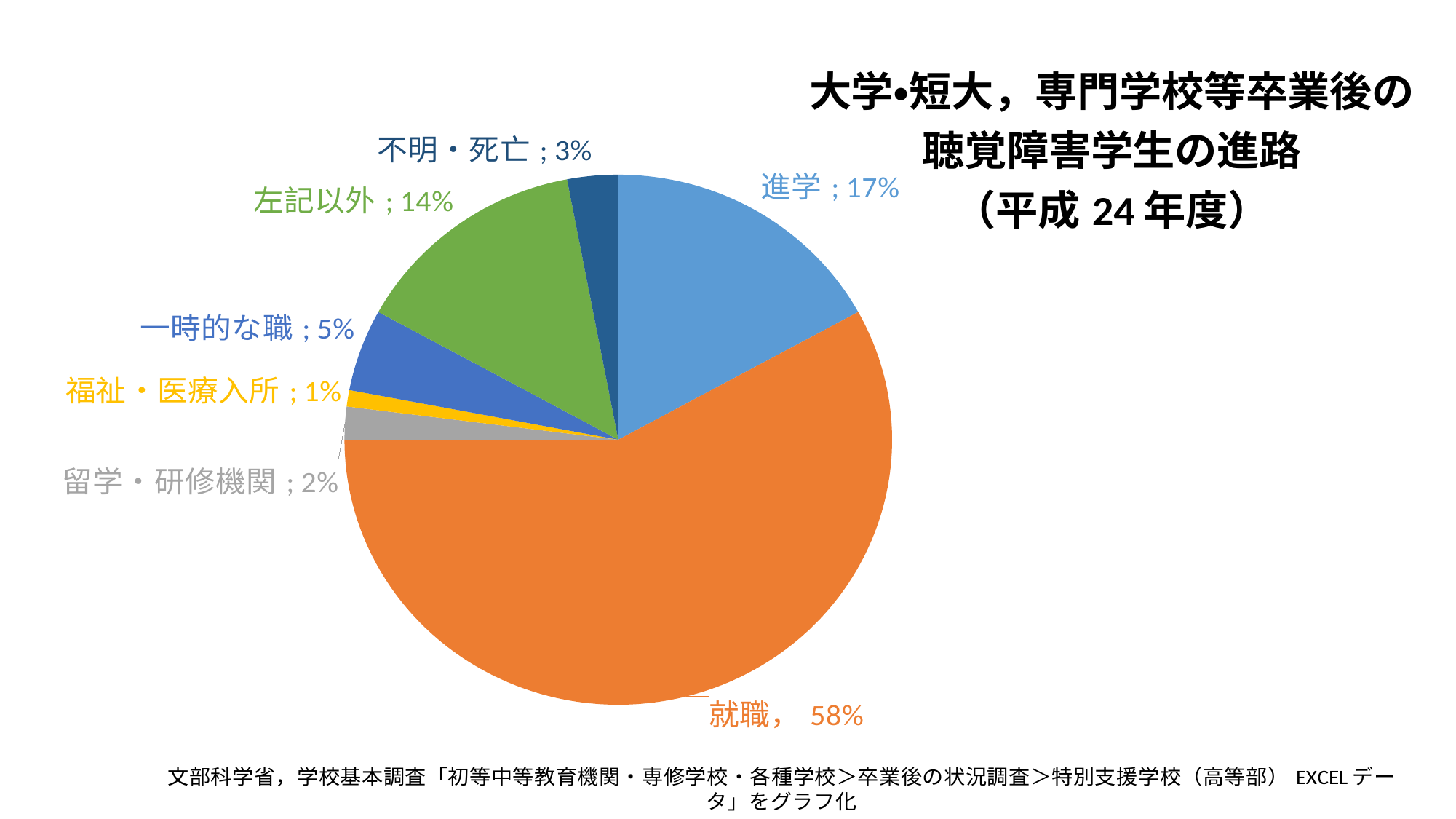
What kind of chart is shown on the slide? pie chart What share of the pie does 就職 represent? 58% What is the title of the chart? 大学•短大，専門学校等卒業後の聴覚障害学生の進路（平成 24 年度） What is the value for 不明・死亡? 3% What is the value for 一時的な職? 5% How many categories are shown in the pie chart? 7 What is the value for 左記以外? 14% Which is larger, 左記以外 or 一時的な職? 左記以外 What is the value for 進学? 17% Which category has the largest slice? 就職 Which category has the smallest slice? 福祉・医療入所 What is the difference between the values for 就職 and 進学? 41%